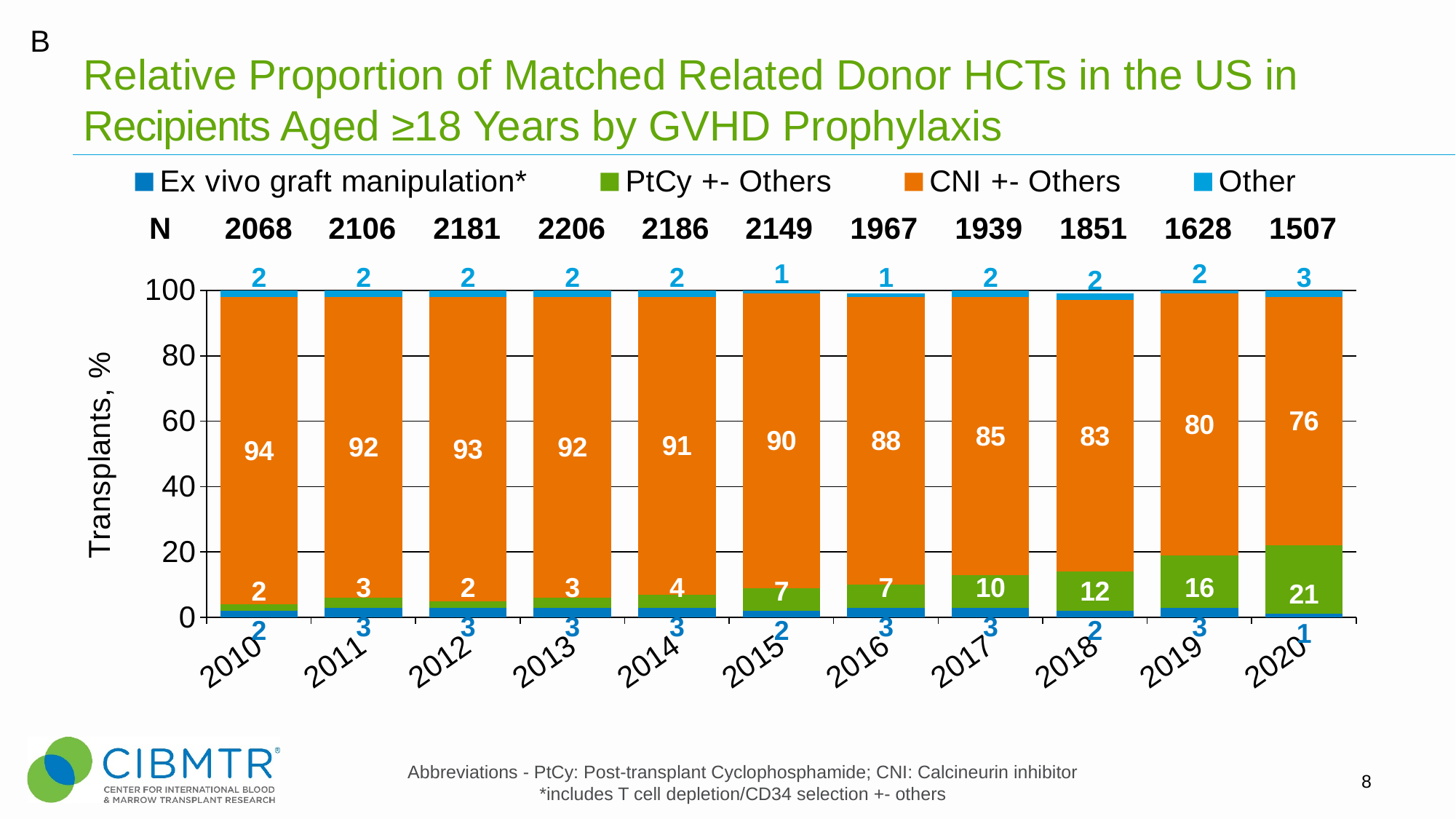
What percentage of transplants used PtCy +- Others in 2020? 21 Which is larger, the PtCy +- Others percentage in 2017 or in 2018? 2018 What is the difference between the CNI +- Others percentage in 2010 and in 2020? 18 What percentage of transplants used CNI +- Others in 2010? 94 What kind of chart is shown on the slide? Stacked bar chart What is the N value shown for 2013? 2206 In which year is the PtCy +- Others percentage highest? 2020 How many years are shown on the x axis? 11 What is the label of the y axis? Transplants, % Does the CNI +- Others percentage rise or fall from 2010 to 2020? Fall In which year is the CNI +- Others percentage lowest? 2020 How many series does the legend list? 4